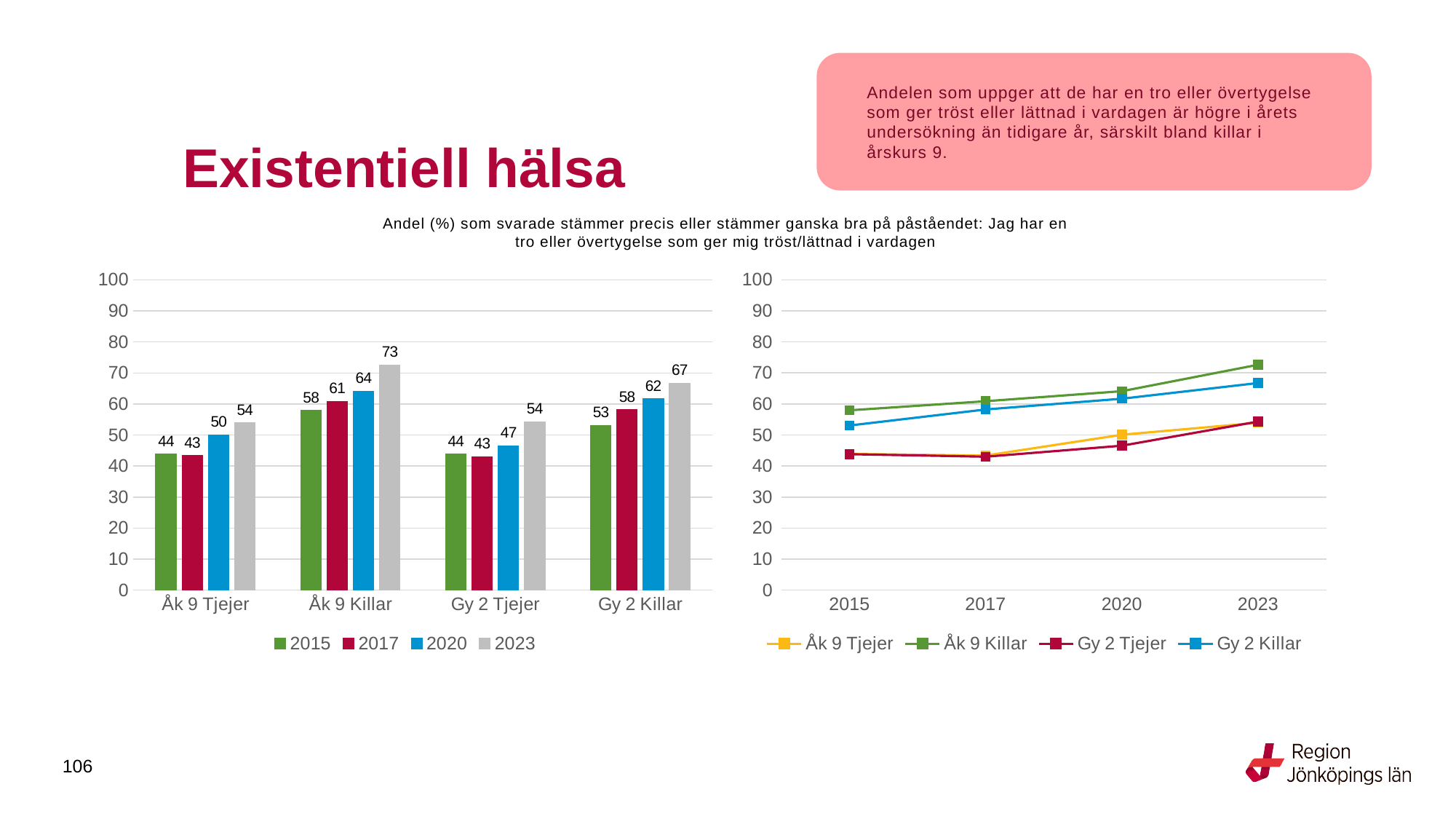
What kind of chart is the chart on the right? Line chart In the bar chart on the left, how many series does the legend list? 4 In the bar chart on the left, what is the value for Gy 2 Tjejer in 2020? 47 In the bar chart on the left, which is larger: the 2017 value for Gy 2 Killar or the 2017 value for Åk 9 Killar? Åk 9 Killar In the bar chart on the left, how many categories are shown on the x axis? 4 In the line chart on the right, which series is shown in yellow? Åk 9 Tjejer In the bar chart on the left, what is the difference between the 2023 and 2015 values for Åk 9 Killar? 15 In the line chart on the right, does the Åk 9 Killar line rise or fall from 2015 to 2023? Rises In the bar chart on the left, what is the value for Åk 9 Killar in 2023? 73 In the bar chart on the left, which category has the lowest value for 2020? Gy 2 Tjejer In the bar chart on the left, which category has the highest value for 2023? Åk 9 Killar In the line chart on the right, is the value for Gy 2 Tjejer in 2017 greater or less than 50? less